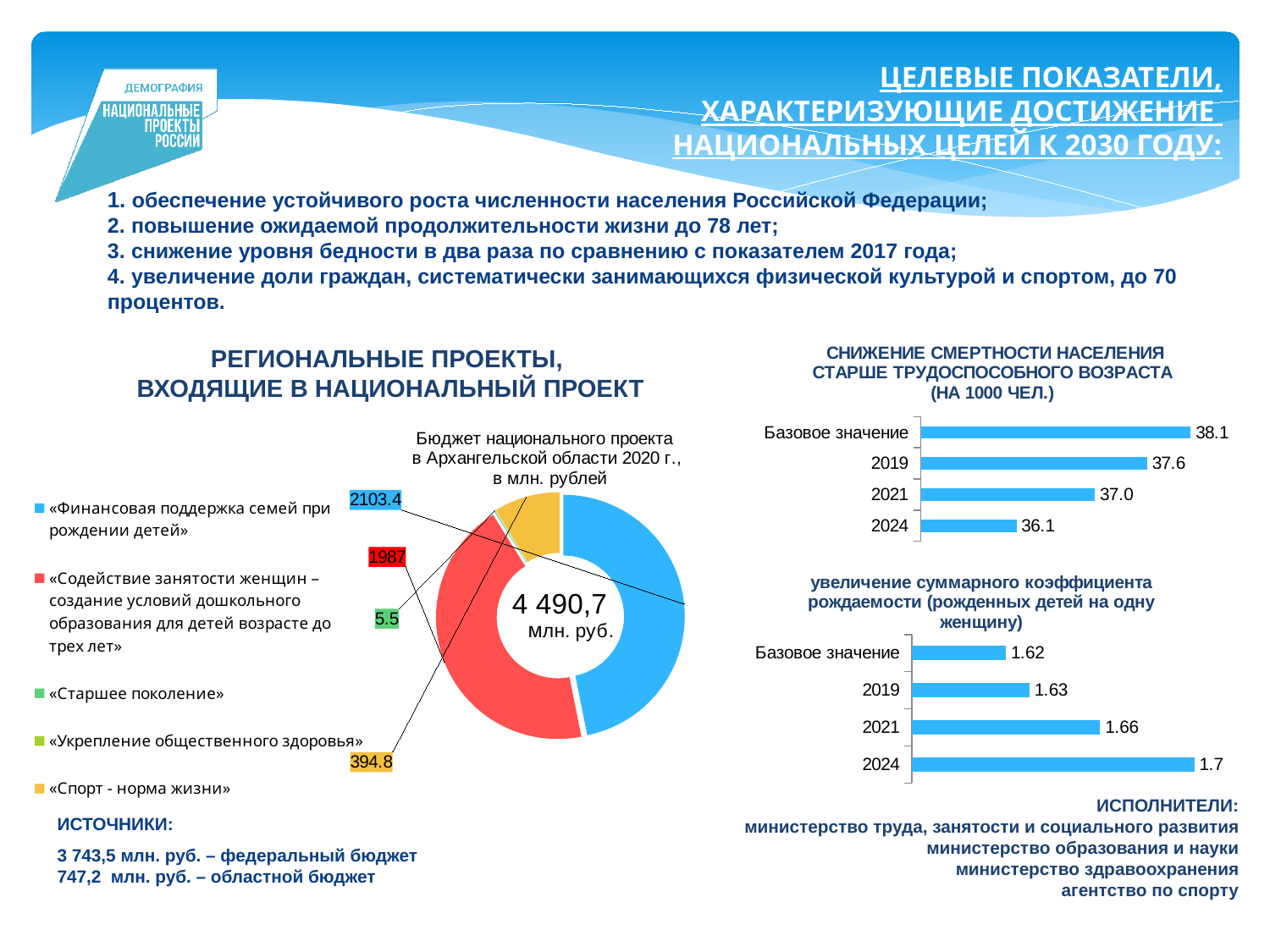
In the budget chart (Бюджет национального проекта в Архангельской области 2020 г.), which is larger: «Спорт - норма жизни» or «Старшее поколение»? «Спорт - норма жизни» In the fertility chart (увеличение суммарного коэффициента рождаемости), do the values rise or fall from Базовое значение to 2024? rise In the mortality chart (Снижение смертности населения старше трудоспособного возраста), do the values rise or fall from Базовое значение to 2024? fall In the fertility chart (увеличение суммарного коэффициента рождаемости), what is the value for 2021? 1.66 In the budget chart (Бюджет национального проекта в Архангельской области 2020 г.), what is the value for «Финансовая поддержка семей при рождении детей»? 2103.4 In the fertility chart (увеличение суммарного коэффициента рождаемости), which category has the highest value? 2024 In the mortality chart (Снижение смертности населения старше трудоспособного возраста), which category has the lowest value? 2024 In the mortality chart (Снижение смертности населения старше трудоспособного возраста), what is the difference between the 2019 value and the 2021 value? 0.6 In the fertility chart (увеличение суммарного коэффициента рождаемости), how many categories are plotted? 4 What kind of chart is the budget chart (Бюджет национального проекта в Архангельской области 2020 г.)? doughnut chart In the mortality chart (Снижение смертности населения старше трудоспособного возраста), what is the value for Базовое значение? 38.1 In the mortality chart (Снижение смертности населения старше трудоспособного возраста), what is the value for 2024? 36.1